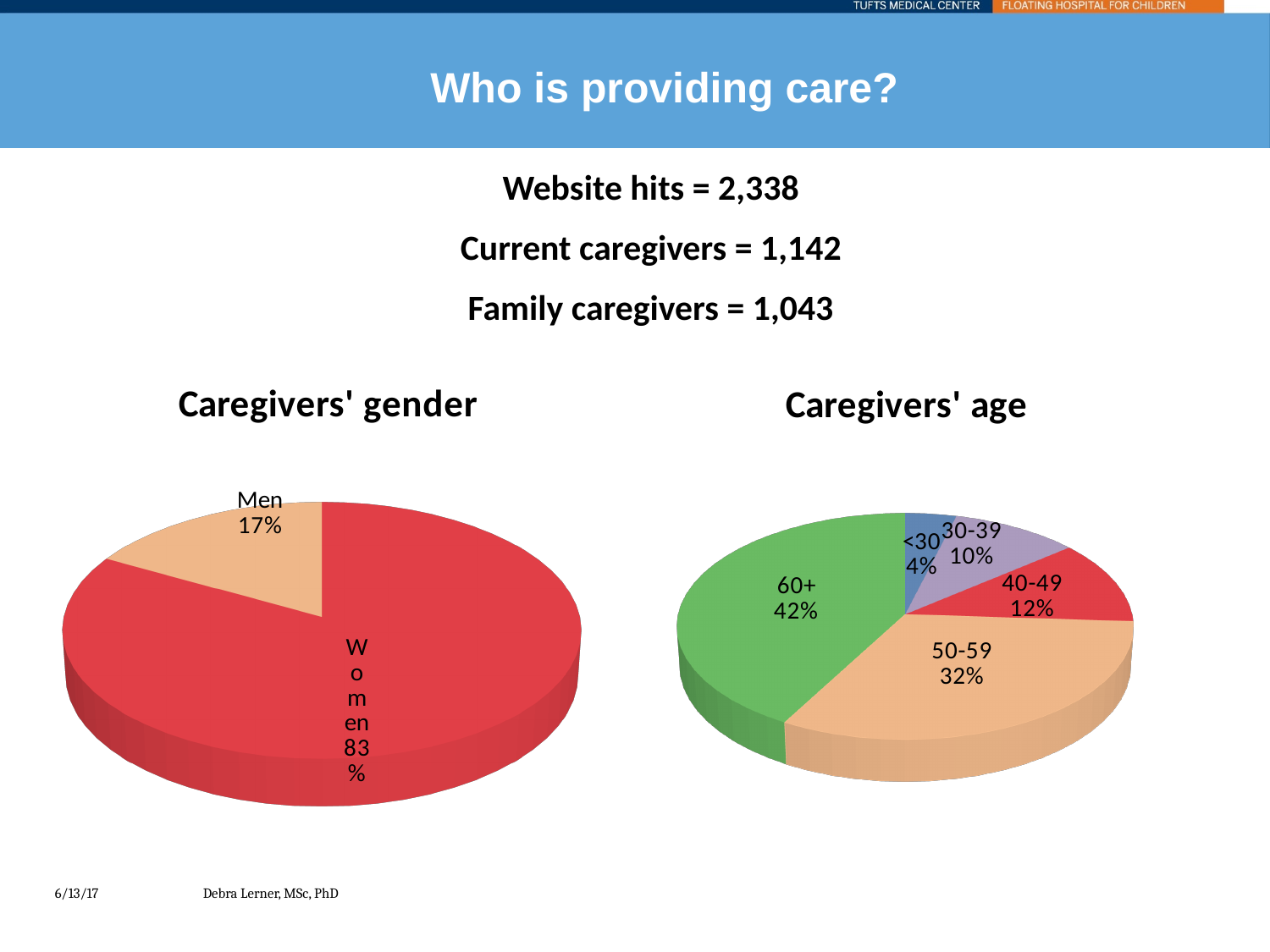
In the Caregivers' gender chart, what percentage of caregivers are men? 17% How many age groups are shown in the Caregivers' age chart? 5 In the Caregivers' age chart, what is the difference in percentage points between the 60+ and 50-59 groups? 10 In the Caregivers' gender chart, what percentage of caregivers are women? 83% What type of chart is the Caregivers' gender chart? Pie chart In the Caregivers' age chart, which age group has the largest share? 60+ In the Caregivers' age chart, what percentage of caregivers are aged 50-59? 32% In the Caregivers' age chart, which age group has the smallest share? <30 In the Caregivers' age chart, what percentage of caregivers are under 30? 4% In the Caregivers' age chart, what percentage of caregivers are aged 60+? 42% In the Caregivers' gender chart, what is the difference in percentage points between women and men? 66 In the Caregivers' age chart, which group has a larger share, 30-39 or 40-49? 40-49